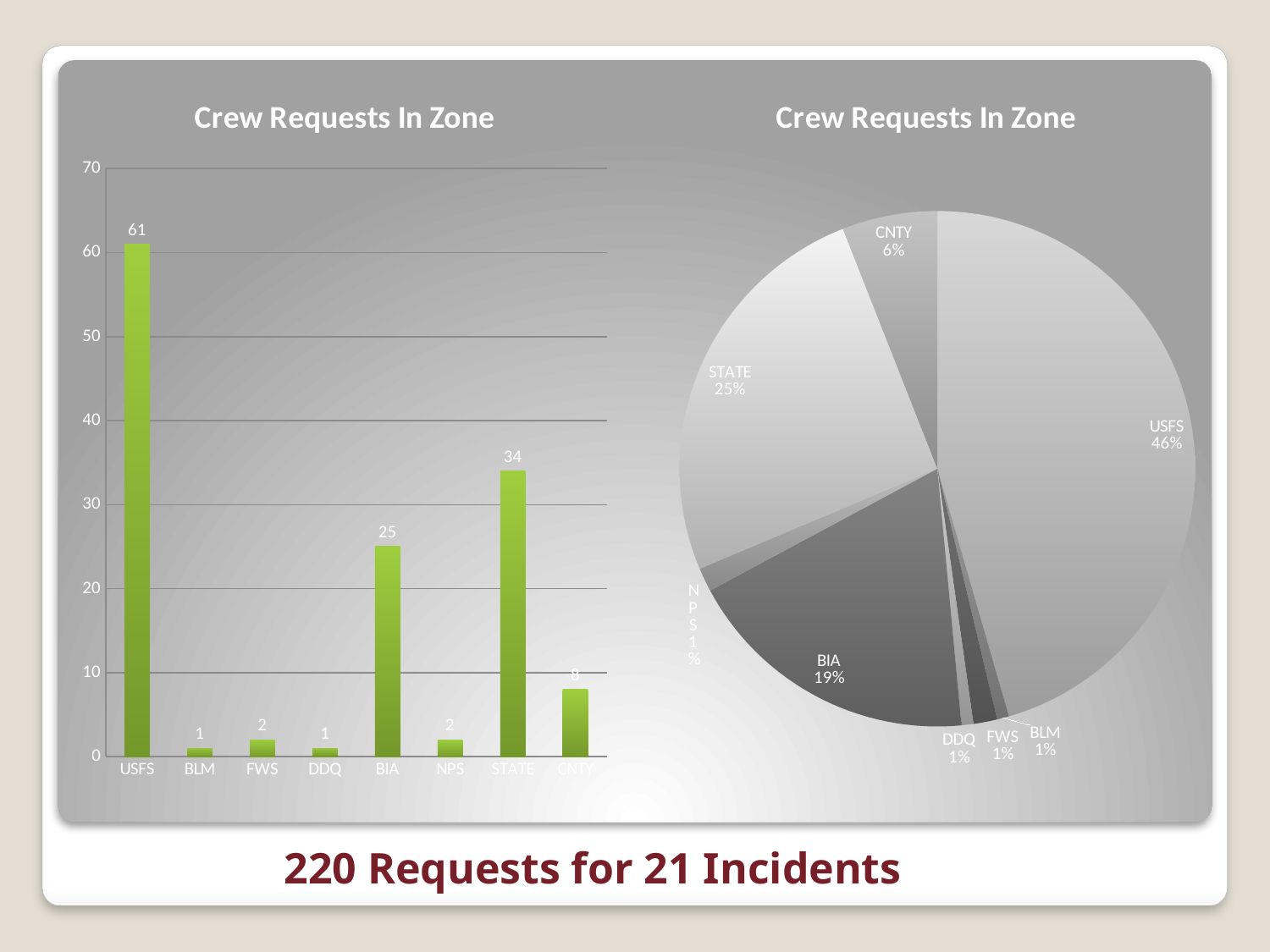
In the bar chart on the left, how many categories are shown on the x axis? 8 In the bar chart on the left, what is the value for CNTY? 8 In the bar chart on the left, which is larger, the value for BIA or the value for CNTY? BIA In the pie chart on the right, what share does USFS have? 46% In the bar chart on the left, which category has the highest value? USFS In the bar chart on the left, what is the value for STATE? 34 In the pie chart on the right, what share does BIA have? 19% In the bar chart on the left, what is the value for USFS? 61 What is the title of the pie chart on the right? Crew Requests In Zone In the pie chart on the right, which slice is the largest? USFS In the bar chart on the left, what is the difference between the values for USFS and STATE? 27 What kind of chart is the chart on the left of the slide? Bar chart